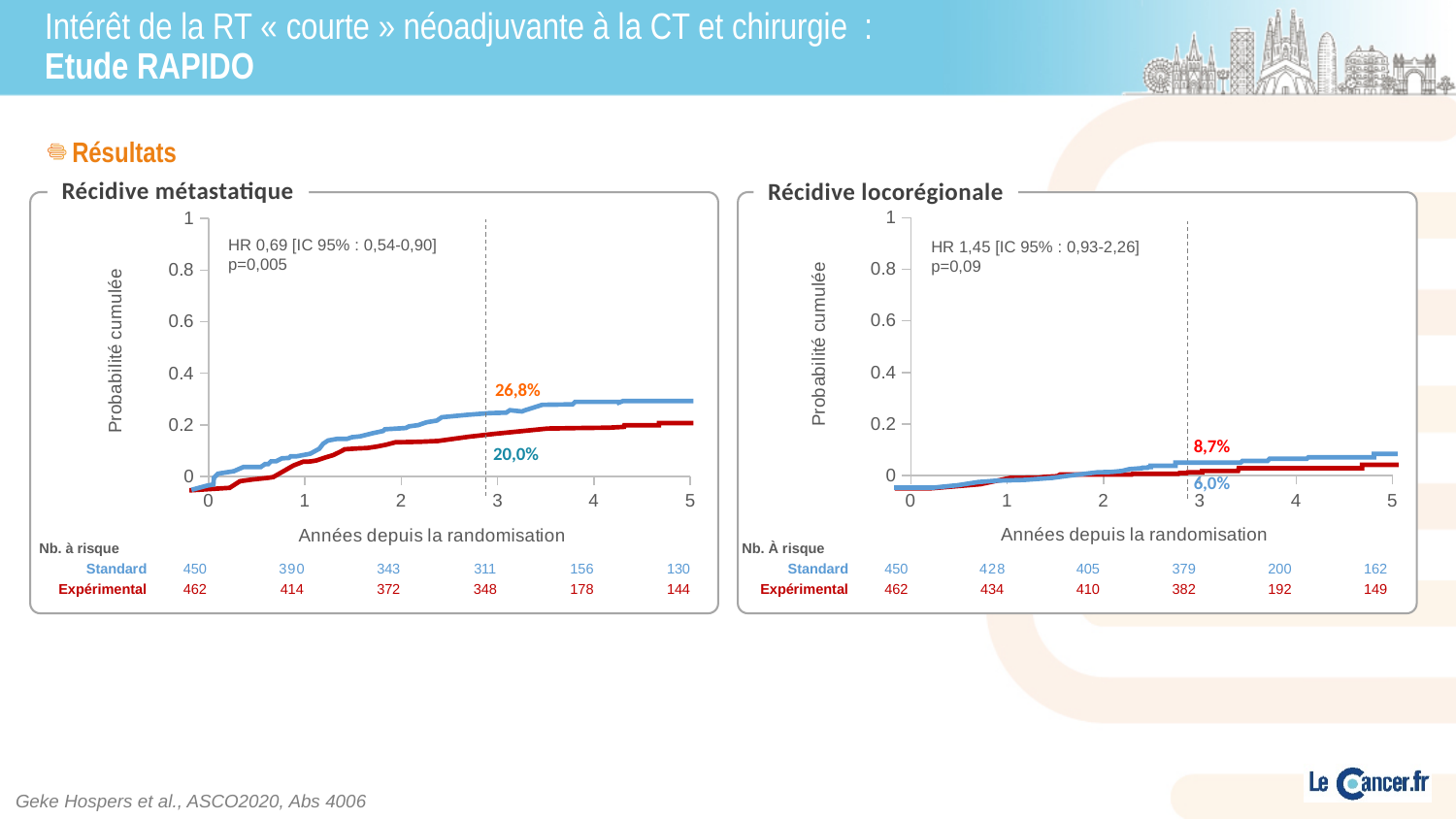
In the 'Récidive locorégionale' chart, what is the difference between the two percentages labelled at 3 years? 2,7 points In the 'Récidive locorégionale' chart, what is the hazard ratio shown? HR 1,45 [IC 95% : 0,93-2,26] In the 'Récidive métastatique' chart, how many patients are at risk in the Standard group at year 0? 450 What kind of chart is the 'Récidive métastatique' chart? Line chart In the 'Récidive locorégionale' chart, what is the lower of the two percentages labelled at 3 years? 6,0% In the 'Récidive locorégionale' chart, how many patients are at risk in the Expérimental group at year 5? 149 In the 'Récidive métastatique' chart, do the curves rise or fall as the years since randomisation increase? Rise In the 'Récidive métastatique' chart, what is the higher of the two percentages labelled at 3 years? 26,8% In the 'Récidive métastatique' chart, what p-value is shown? p=0,005 In the 'Récidive métastatique' chart, what is the hazard ratio shown? HR 0,69 [IC 95% : 0,54-0,90] In the 'Récidive locorégionale' chart, what p-value is shown? p=0,09 In the 'Récidive métastatique' chart, what is the difference between the two percentages labelled at 3 years? 6,8 points